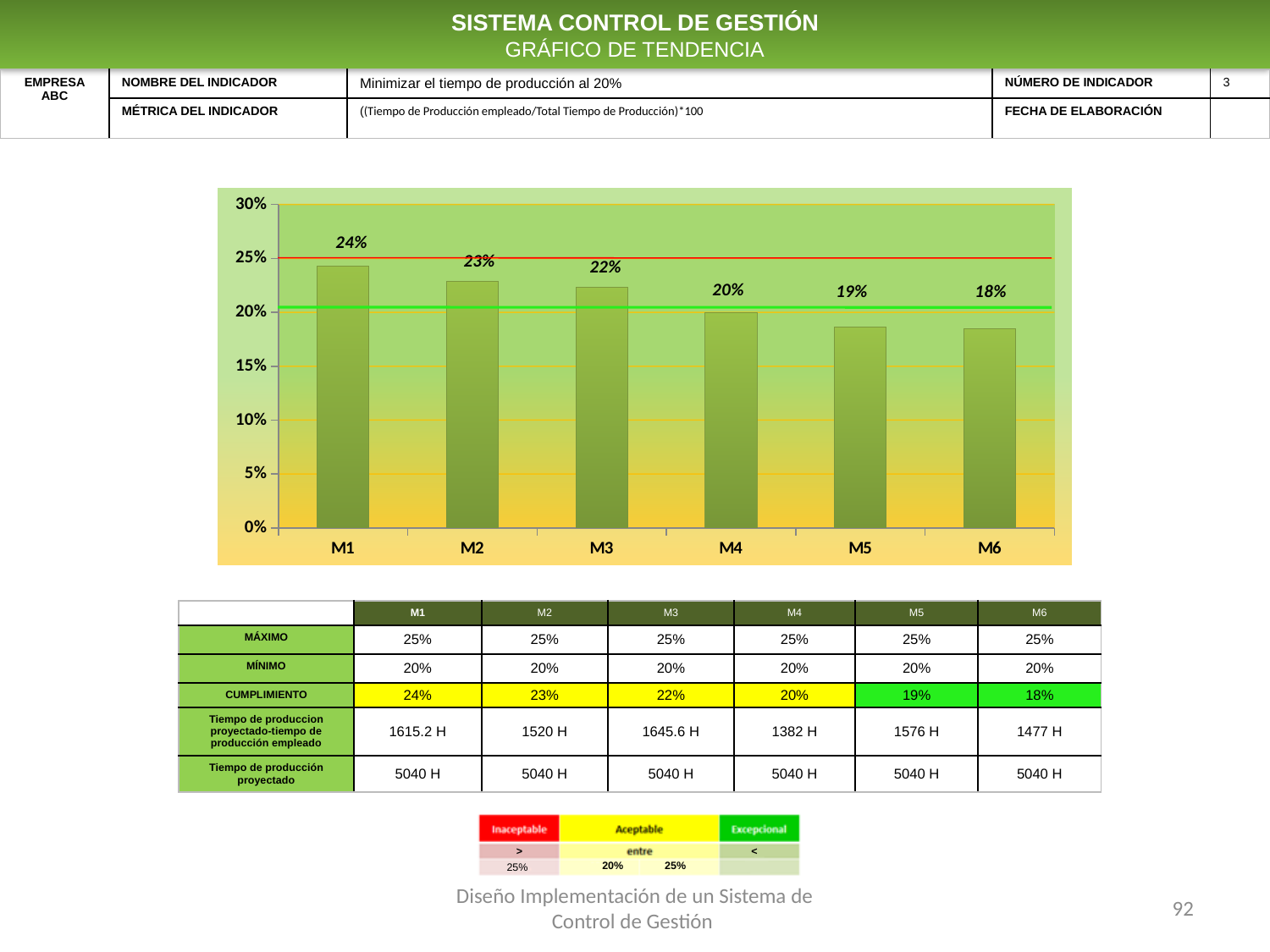
What kind of chart is shown on the slide? bar chart What is the difference between the values for M1 and M6? 6% What is the value for M4 in the bar chart? 20% Do the values rise or fall from M1 to M6? fall What is the highest value shown on the y axis of the chart? 30% What is the value for M1 in the bar chart? 24% Which is larger, the value for M2 or the value for M5? M2 Is the value for M3 greater or less than 20%? greater What is the value for M6 in the bar chart? 18% Which month has the lowest value in the bar chart? M6 How many months are shown on the x axis of the bar chart? 6 Which month has the highest value in the bar chart? M1